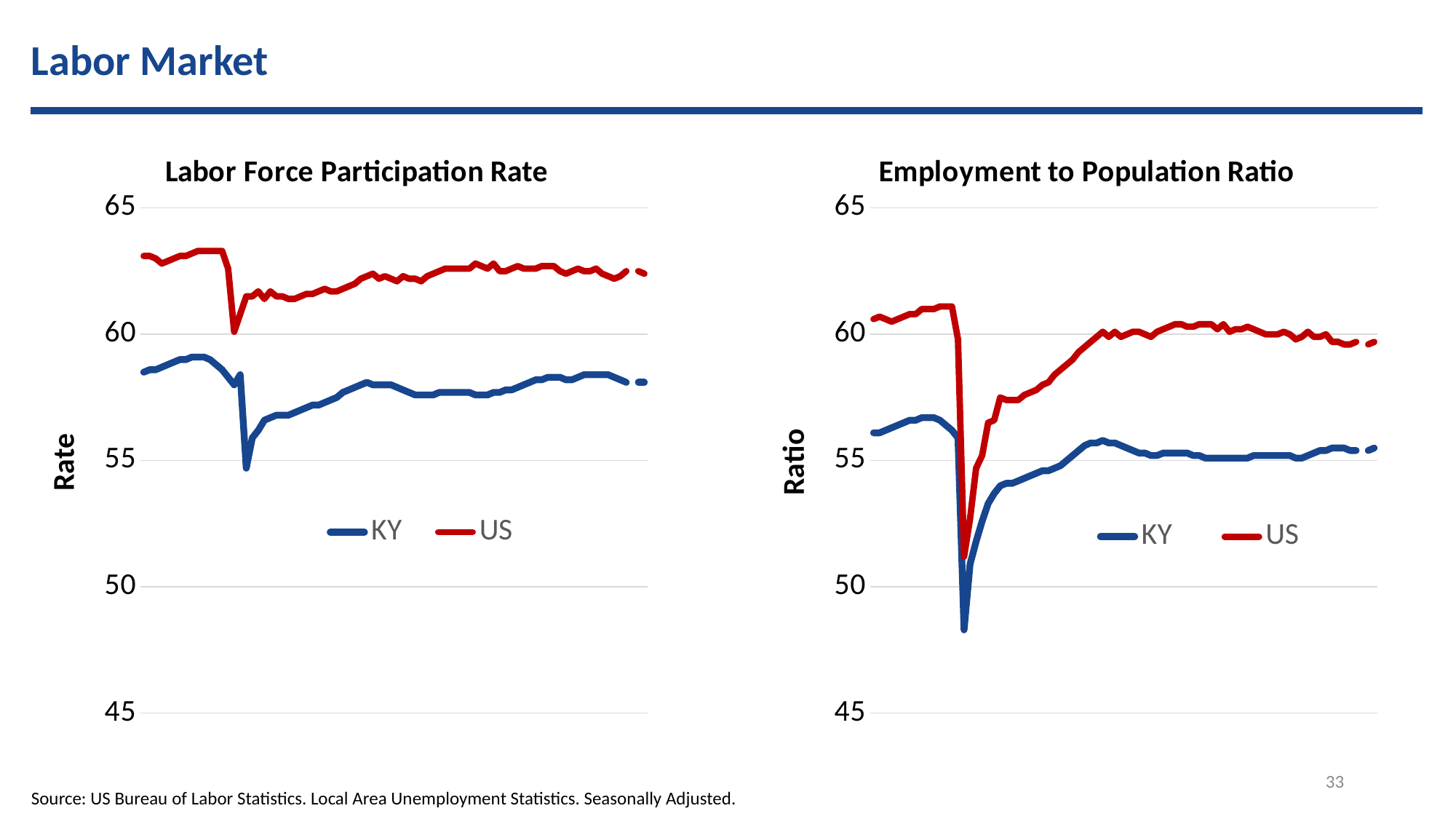
What is the y-axis title of the Employment to Population Ratio chart? Ratio In the Employment to Population Ratio chart, which series drops to a lower point during the sharp dip, KY or US? KY In the Labor Force Participation Rate chart, is the lowest value of the KY line greater or less than 55? less In the Labor Force Participation Rate chart, is the highest value of the US line greater or less than 60? greater In the Employment to Population Ratio chart, is the highest value of the US line greater or less than 60? greater In the Employment to Population Ratio chart, which series is higher throughout, KY or US? US What kind of chart is the Labor Force Participation Rate chart? line chart In the Labor Force Participation Rate chart, which series is higher throughout, KY or US? US How many series does the legend of the Employment to Population Ratio chart list? 2 What kind of chart is the Employment to Population Ratio chart? line chart Which series are listed in the legend of the Labor Force Participation Rate chart? KY and US